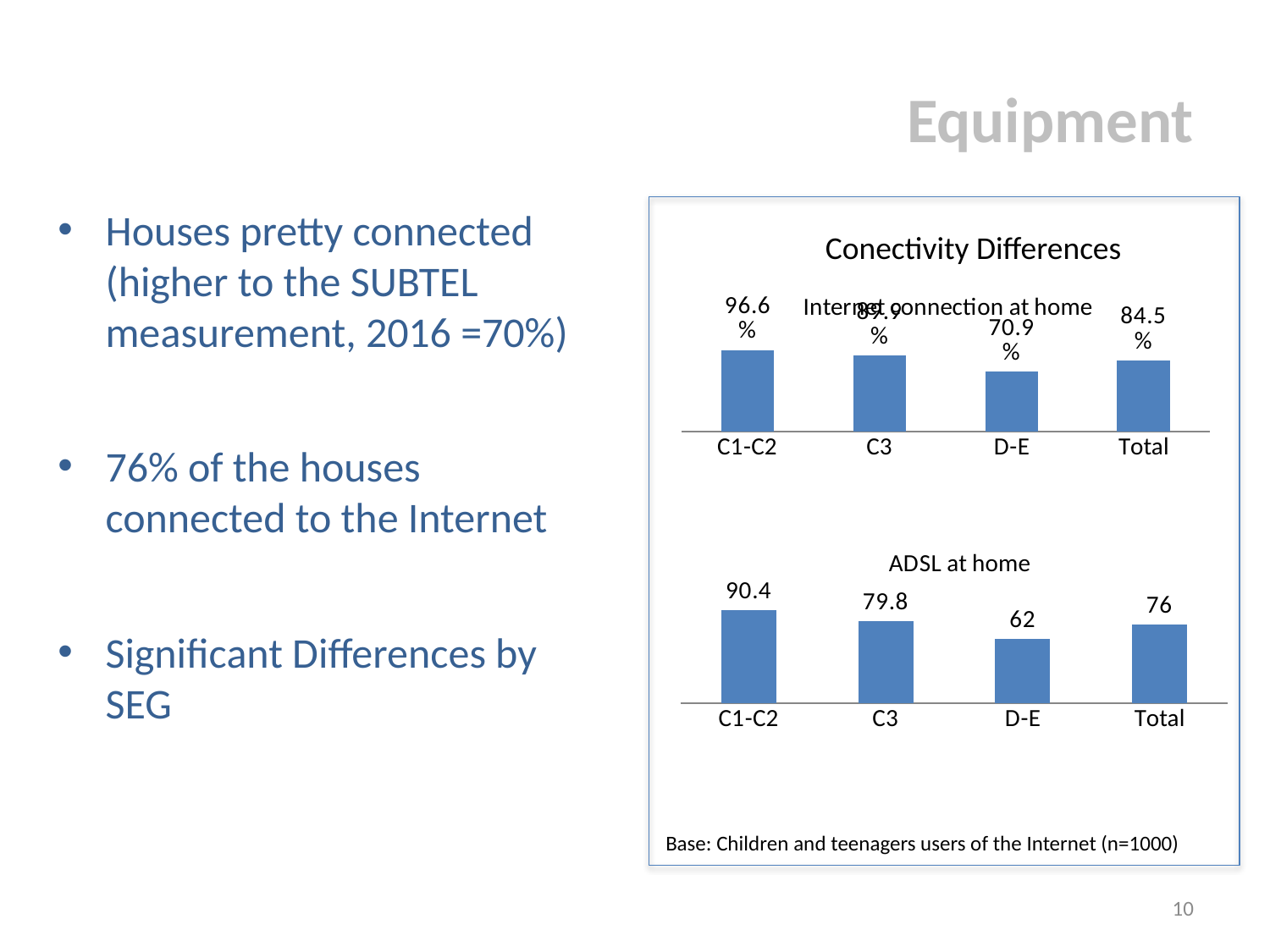
In the 'Internet connection at home' chart, which category has the lowest value? D-E In the 'ADSL at home' chart, what is the difference between the C1-C2 value and the Total value? 14.4 How many categories are shown in the 'ADSL at home' chart? 4 In the 'ADSL at home' chart, what is the value for D-E? 62 In the 'ADSL at home' chart, which category has the highest value? C1-C2 In the 'Internet connection at home' chart, what is the value for D-E? 70.9% What type of chart is the 'Internet connection at home' chart? Bar chart In the 'Internet connection at home' chart, what is the value for C1-C2? 96.6% In the 'ADSL at home' chart, which is larger, the value for C3 or the value for Total? C3 In the 'Internet connection at home' chart, what is the value for Total? 84.5% In the 'Internet connection at home' chart, what is the difference between the C1-C2 value and the D-E value? 25.7% In the 'ADSL at home' chart, what is the value for C3? 79.8